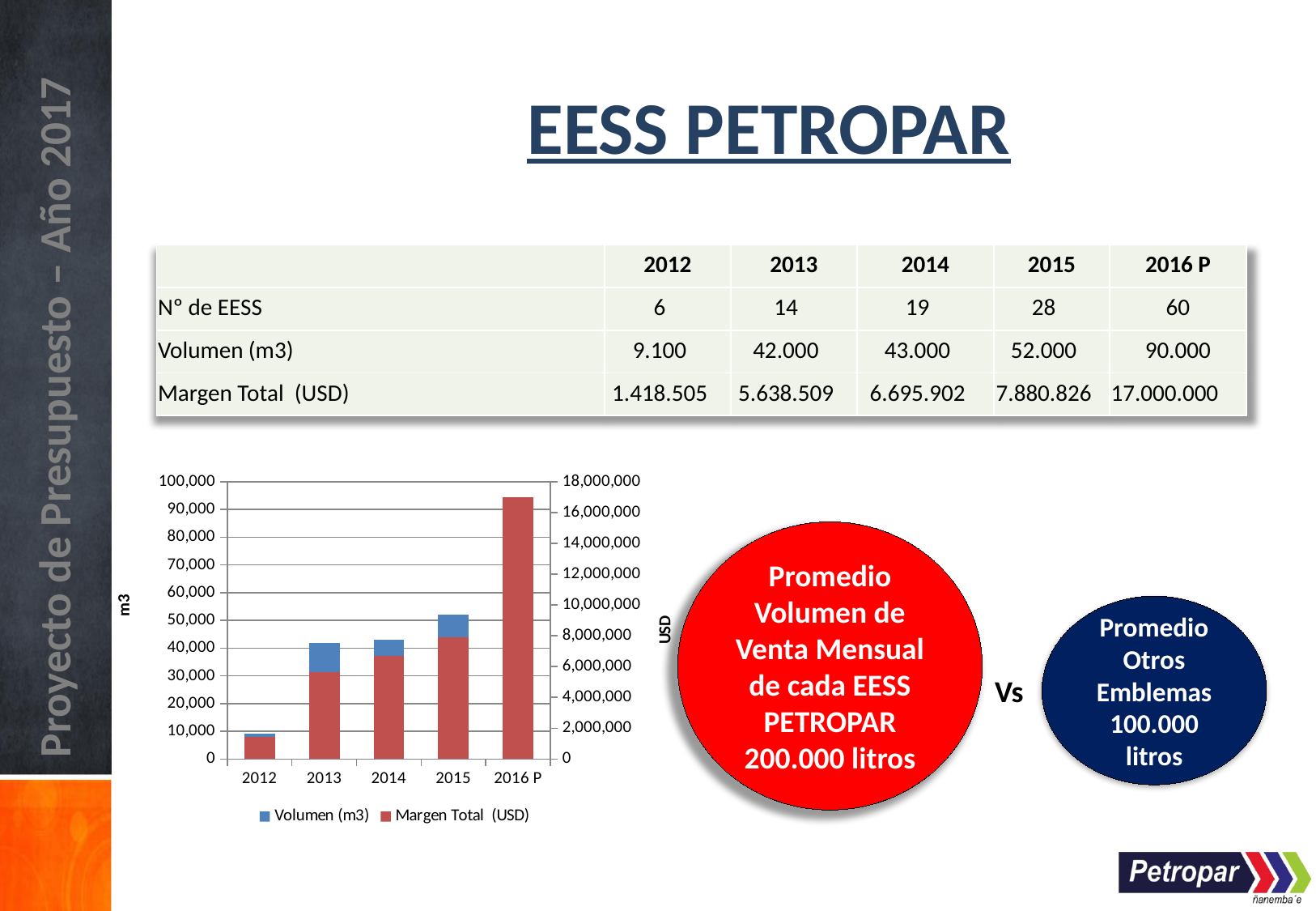
What label is shown on the right-hand vertical axis of the chart? USD Which year has the lowest Volumen (m3) in the chart? 2012 Which is larger in the chart, the Margen Total (USD) for 2014 or for 2013? 2014 What kind of chart is shown on the slide? bar chart Is the Margen Total (USD) for 2013 greater or less than 6,000,000? less How many year categories are shown on the x axis of the chart? 5 Is the Margen Total (USD) for 2014 greater or less than 6,000,000? greater Do the Margen Total (USD) values rise or fall from 2012 to 2016 P in the chart? rise How many series does the chart legend list? 2 Is the Margen Total (USD) for 2016 P greater or less than 16,000,000? greater Which year has the highest Margen Total (USD) in the chart? 2016 P